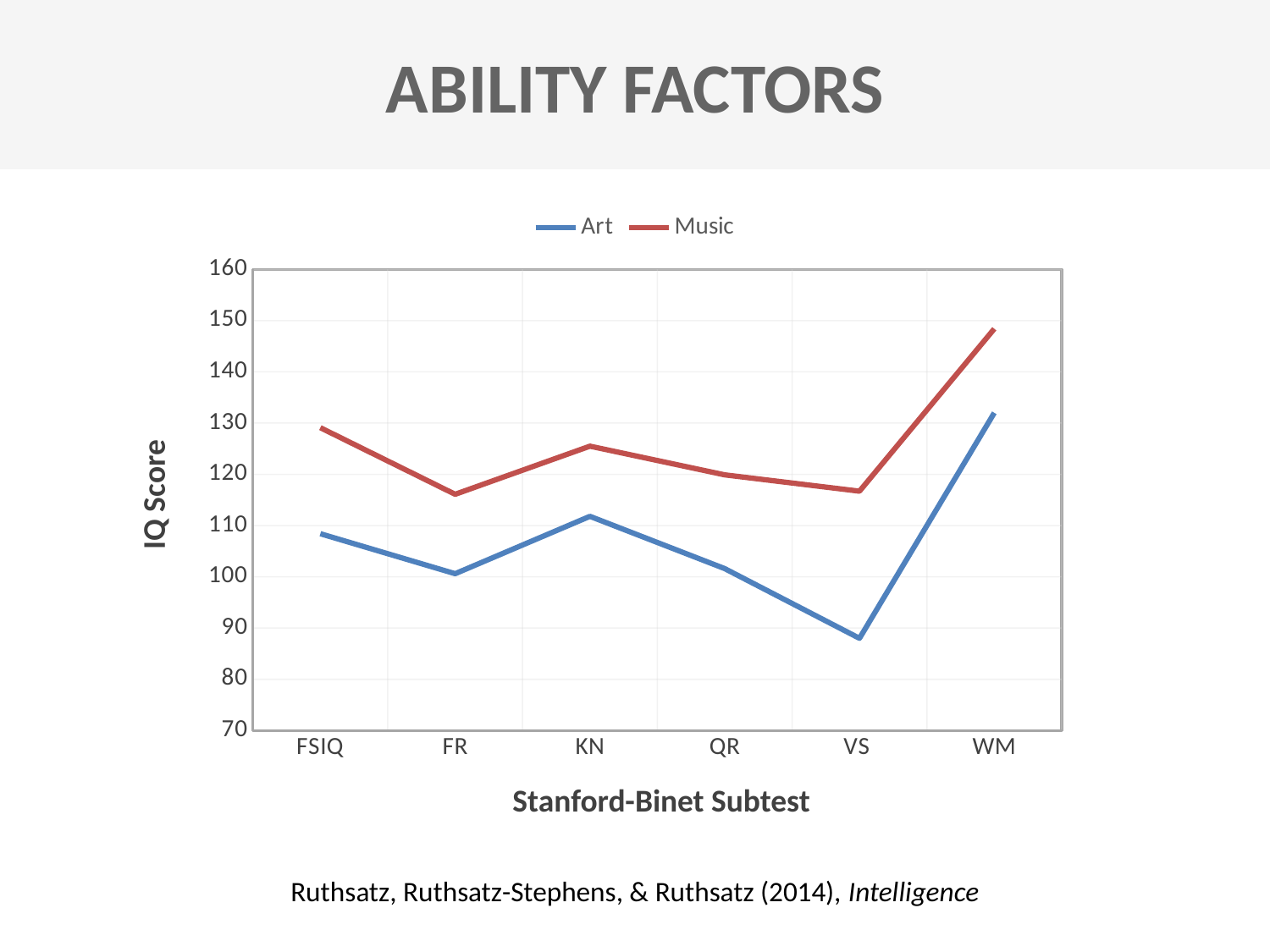
Is the Music value for WM greater or less than 140? greater At WM, which series has the larger value, Art or Music? Music Is the Music value for FR greater or less than 120? less Is the Art value for VS greater or less than 100? less What is the title of the y axis? IQ Score How many series does the legend list? 2 For which subtest is the Art series lowest? VS Does the Art series rise or fall from QR to VS? fall For which subtest is the Music series highest? WM How many subtests are shown along the x axis? 6 For which subtest is the Art series highest? WM What kind of chart is shown on the slide? line chart